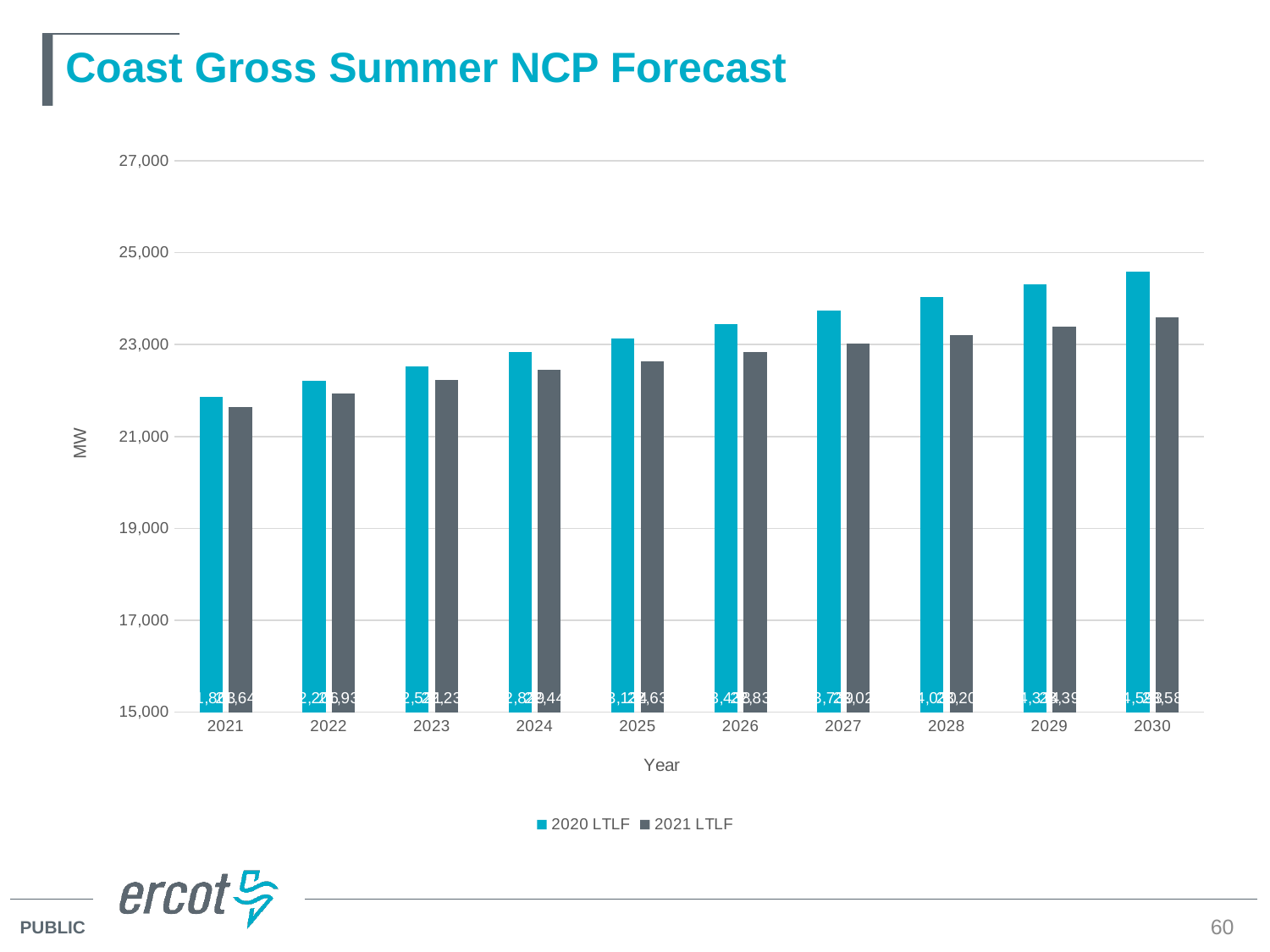
How many series does the legend list? 2 Which year has the lowest 2021 LTLF value? 2021 Is the 2020 LTLF value for 2030 greater or less than 25,000? less Do the 2020 LTLF values rise or fall from 2021 to 2030? rise Is the 2021 LTLF value for 2021 greater or less than 21,000? greater Which year has the highest 2020 LTLF value? 2030 Is the 2020 LTLF value for 2026 greater or less than 23,000? greater How many years are shown on the x axis? 10 What is the label on the y axis? MW In 2030, which series has the larger value, 2020 LTLF or 2021 LTLF? 2020 LTLF What kind of chart is shown on the slide? bar chart